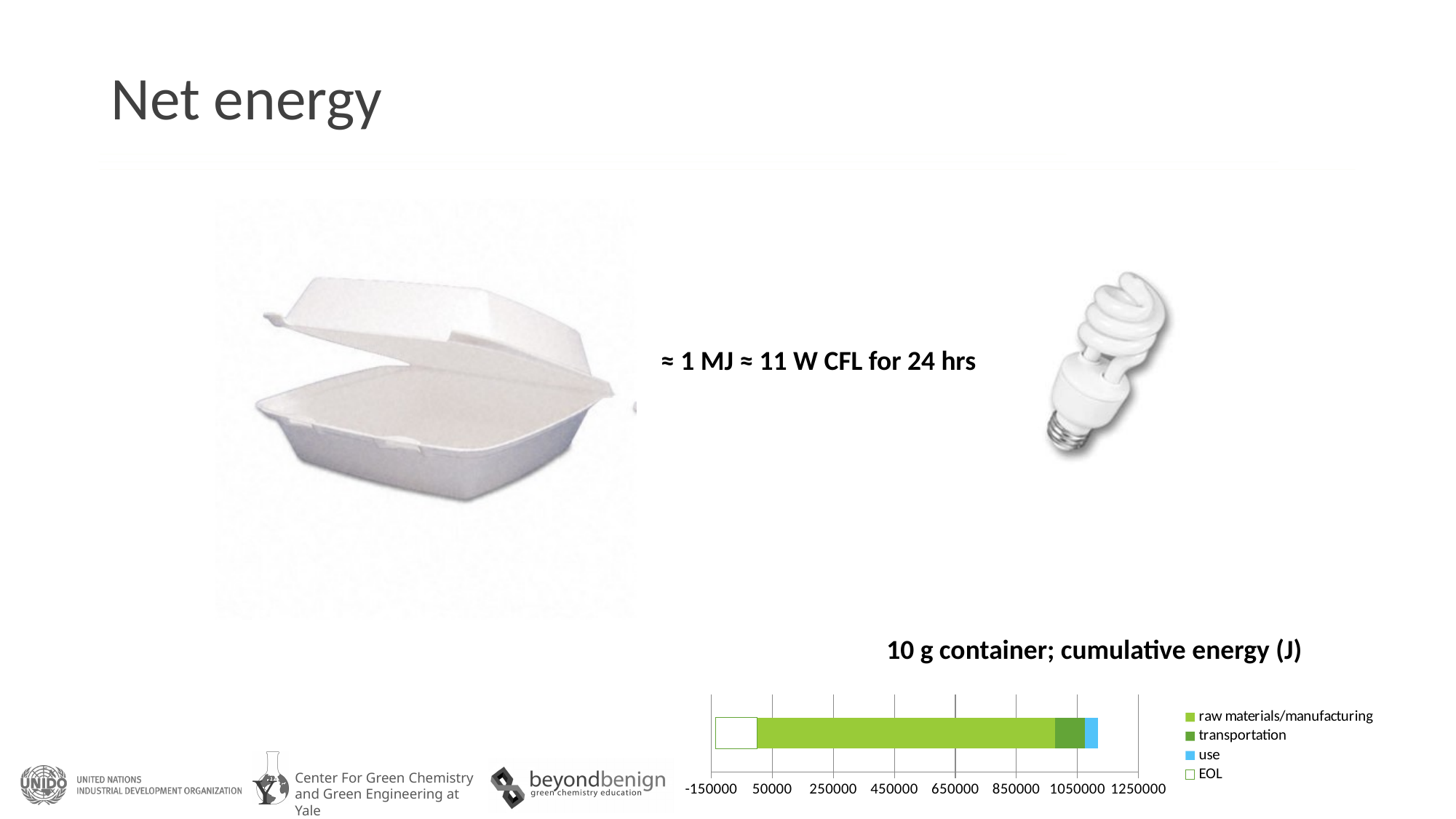
How many stacked bars are plotted in the chart? 1 What is the lowest value shown on the chart's horizontal axis? -150000 How many series does the chart's legend list? 4 Is the value for EOL greater or less than 50000? less Is the value for raw materials/manufacturing greater or less than 650000? greater Is the value for transportation greater or less than 250000? less What kind of chart is shown at the bottom right of the slide? bar chart Which is larger in the chart, the transportation segment or the use segment? transportation Which series accounts for the largest segment of the stacked bar? raw materials/manufacturing What is the title of the chart on the slide? 10 g container; cumulative energy (J) Which legend entry is shown with a white (unfilled) marker? EOL Which is larger in the chart, the raw materials/manufacturing segment or the transportation segment? raw materials/manufacturing